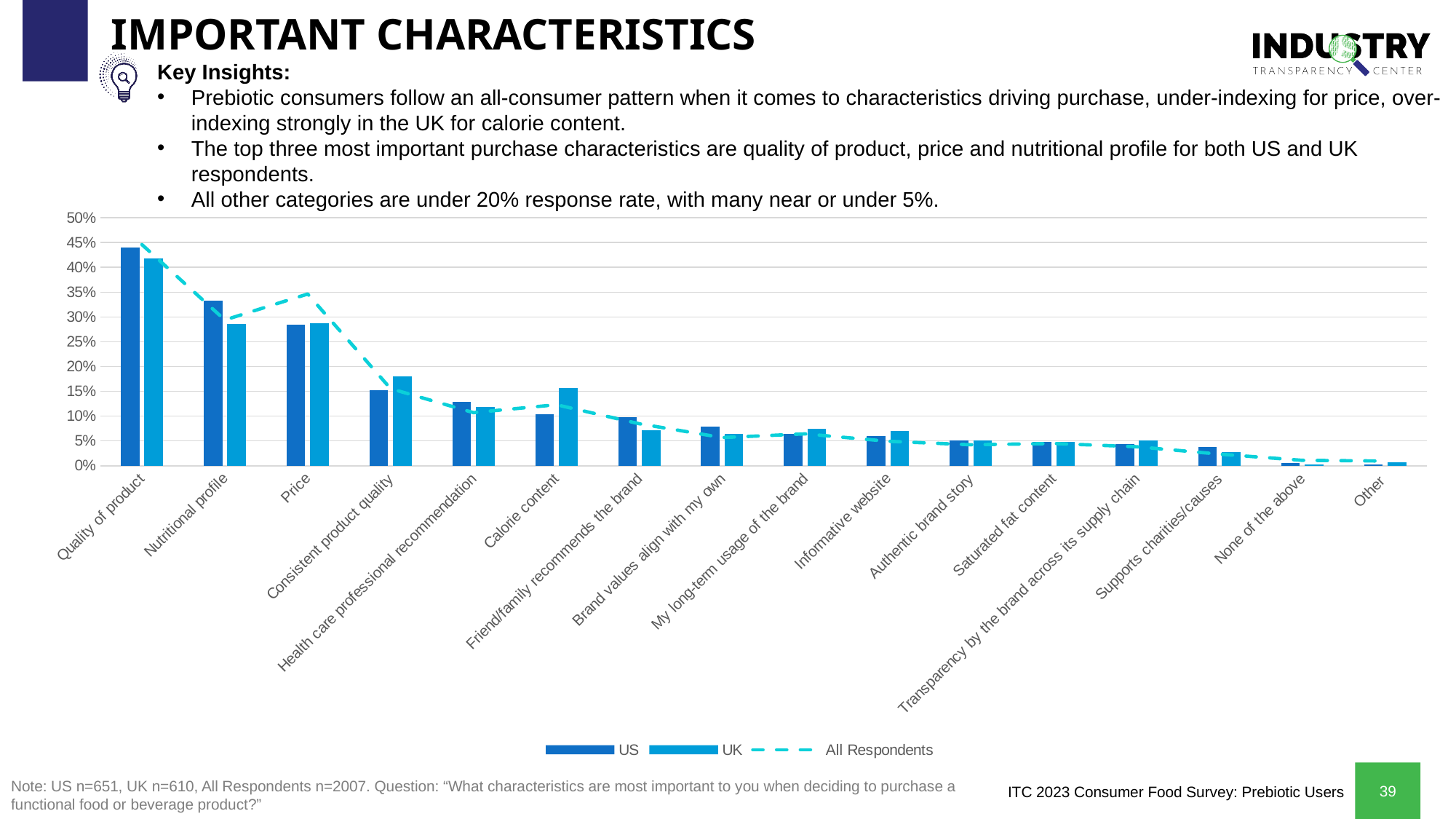
For Calorie content, which is larger: the US value or the UK value? UK Do the values in the chart generally rise or fall moving from left to right along the x axis? fall Is the UK value for Nutritional profile greater or less than 30%? less How many series does the chart legend list? 3 Is the UK value for Calorie content greater or less than 10%? greater How many categories are shown along the x axis of the chart? 16 Which series in the chart is drawn as a dashed line rather than bars? All Respondents Is the US value for Quality of product greater or less than 40%? greater Which category has the highest US value in the chart? Quality of product For Nutritional profile, which is larger: the US value or the UK value? US